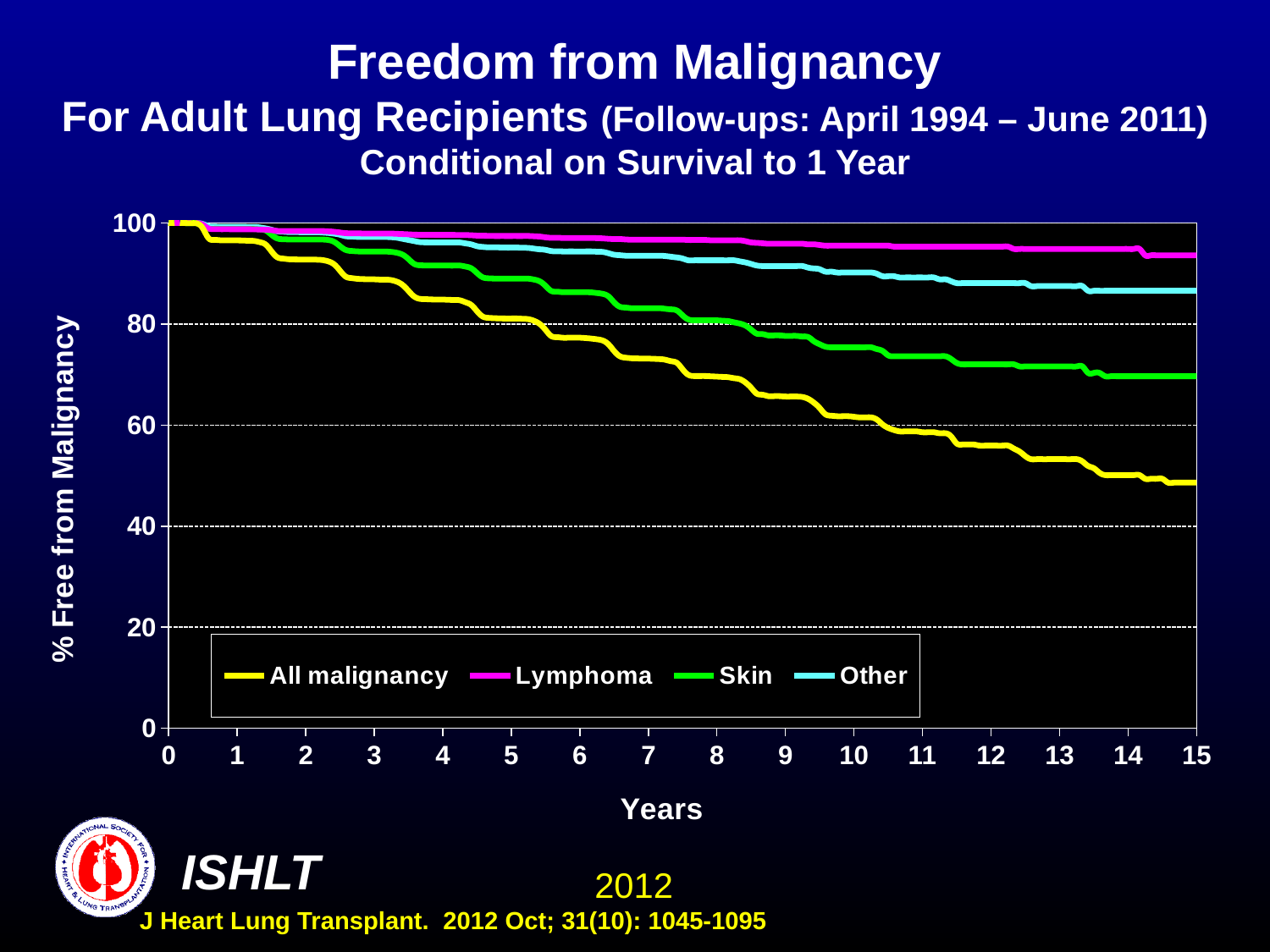
Is the value for Other at 15 years greater or less than 80? greater What is the label of the y axis? % Free from Malignancy Which series has the highest value at 15 years? Lymphoma How many series does the legend list? 4 Do the values for All malignancy rise or fall as years increase? fall Is the value for Skin at 15 years greater or less than 80? less At 15 years, which is larger, the value for Lymphoma or the value for Skin? Lymphoma Is the value for All malignancy at 15 years greater or less than 60? less Which series has the lowest value at 15 years? All malignancy What kind of chart is shown on the slide? line chart